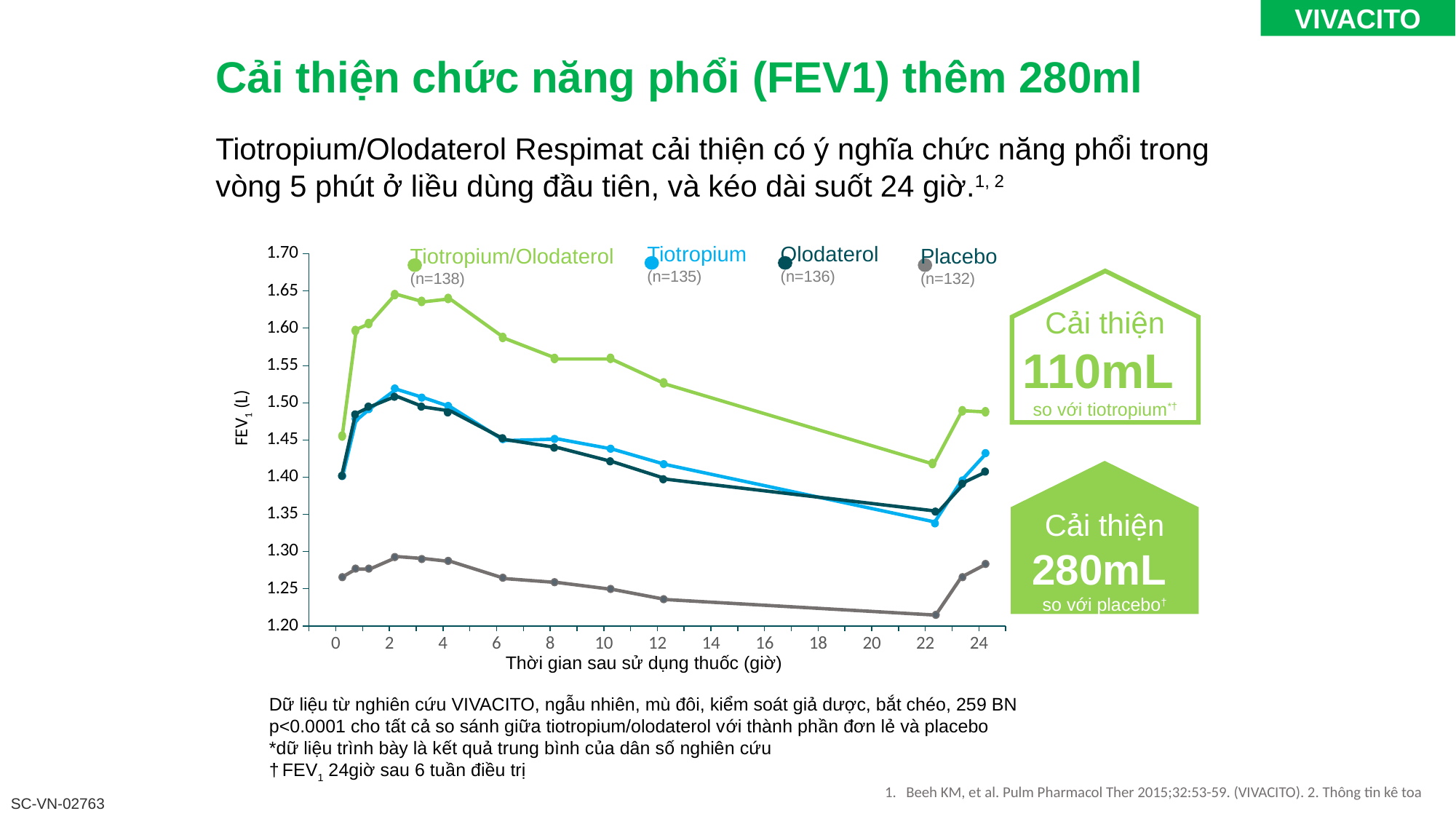
Which series has the lowest FEV1 values across the 24 hours? Placebo Does the Tiotropium/Olodaterol line rise or fall between about 4 hours and 22 hours? fall Which series has the highest FEV1 values across the 24 hours? Tiotropium/Olodaterol What kind of chart is shown on the slide? line chart At about 12 hours, which is larger: the Tiotropium/Olodaterol value or the Placebo value? Tiotropium/Olodaterol Is the Tiotropium value at about 12 hours greater or less than 1.45? less How many series does the chart's legend list? 4 What is the label of the chart's x axis? Thời gian sau sử dụng thuốc (giờ) Is the Placebo value at about 2 hours greater or less than 1.25? greater Is the Placebo value at about 22 hours greater or less than 1.25? less What is the sample size (n) shown in the legend for the Tiotropium/Olodaterol series? n=138